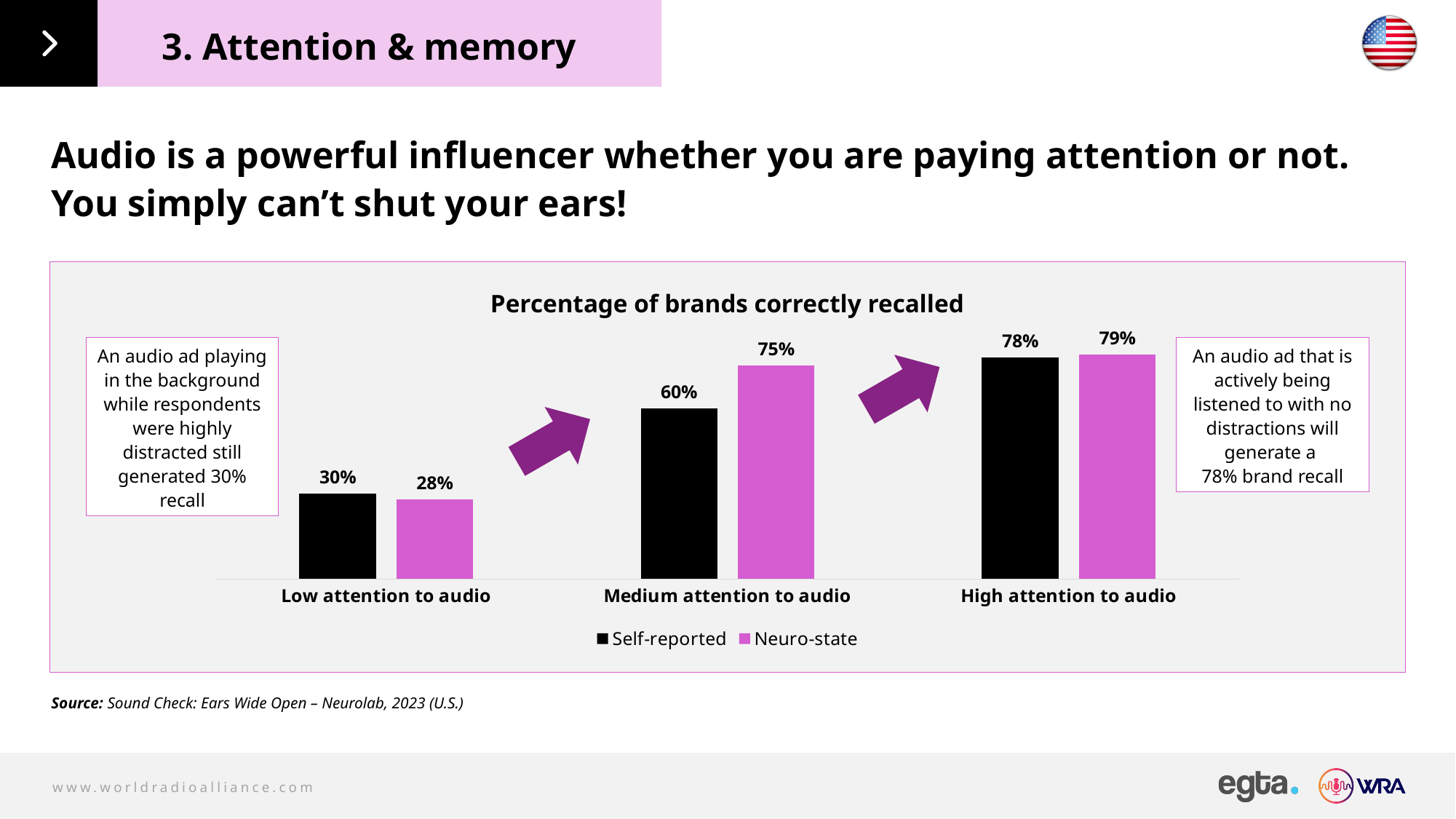
What is the Neuro-state value for Medium attention to audio? 75% What is the Neuro-state value for High attention to audio? 79% Do the Self-reported values rise or fall from Low attention to High attention to audio? Rise Which category has the highest Self-reported value? High attention to audio Which category has the lowest Neuro-state value? Low attention to audio What is the Self-reported value for Low attention to audio? 30% What kind of chart is shown? Bar chart For Low attention to audio, which is larger: the Self-reported value or the Neuro-state value? Self-reported What is the difference between the Neuro-state and Self-reported values for Medium attention to audio? 15% What is the difference between the Self-reported values for High attention to audio and Low attention to audio? 48% How many series does the legend list? 2 How many categories are shown on the x axis? 3